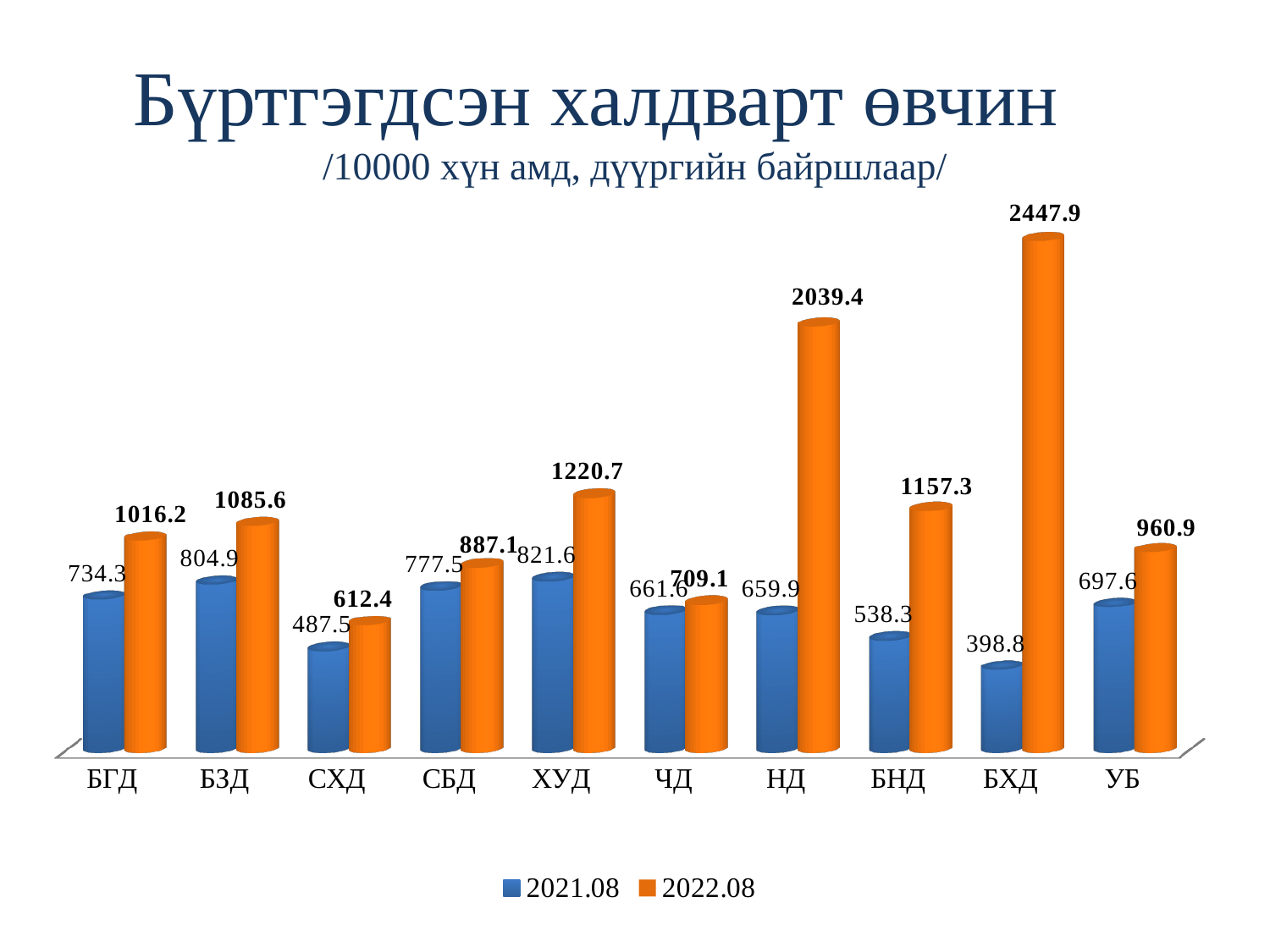
What is the value for УБ in the 2022.08 series? 960.9 How many series does the legend list? 2 Which category has the highest value in the 2022.08 series? БХД Which category has the lowest value in the 2021.08 series? БХД What is the value for СХД in the 2021.08 series? 487.5 Which category has the highest value in the 2021.08 series? ХУД Which colour represents the 2022.08 series? Orange How many categories are shown on the x axis? 10 What is the difference between the 2022.08 and 2021.08 values for НД? 1379.5 What kind of chart is shown on the slide? Bar chart What is the value for БХД in the 2022.08 series? 2447.9 Which is larger for ЧД: the 2021.08 value or the 2022.08 value? 2022.08